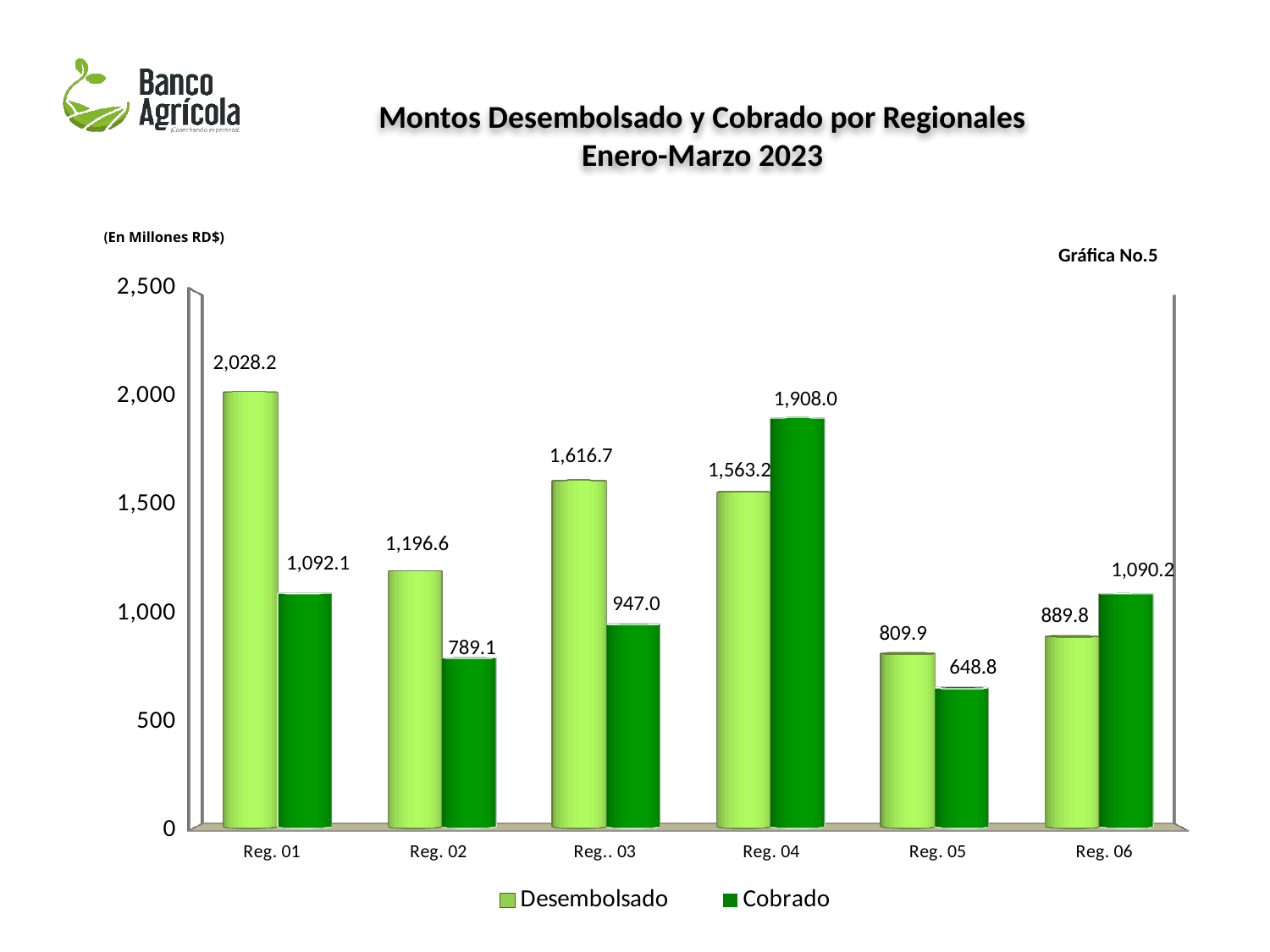
Is the Desembolsado value for Reg.. 03 greater or less than 1,500? greater What is the Cobrado value for Reg. 04? 1,908.0 What kind of chart is shown on the slide? Bar chart What is the Cobrado value for Reg. 05? 648.8 For Reg. 06, which is larger, Desembolsado or Cobrado? Cobrado What is the difference between the Cobrado and Desembolsado values for Reg. 04? 344.8 How many regions are shown on the x axis? 6 Which region has the lowest Cobrado value? Reg. 05 What is the Desembolsado value for Reg. 01? 2,028.2 How many series does the legend list? 2 What is the difference between the Desembolsado and Cobrado values for Reg. 01? 936.1 Which region has the highest Desembolsado value? Reg. 01